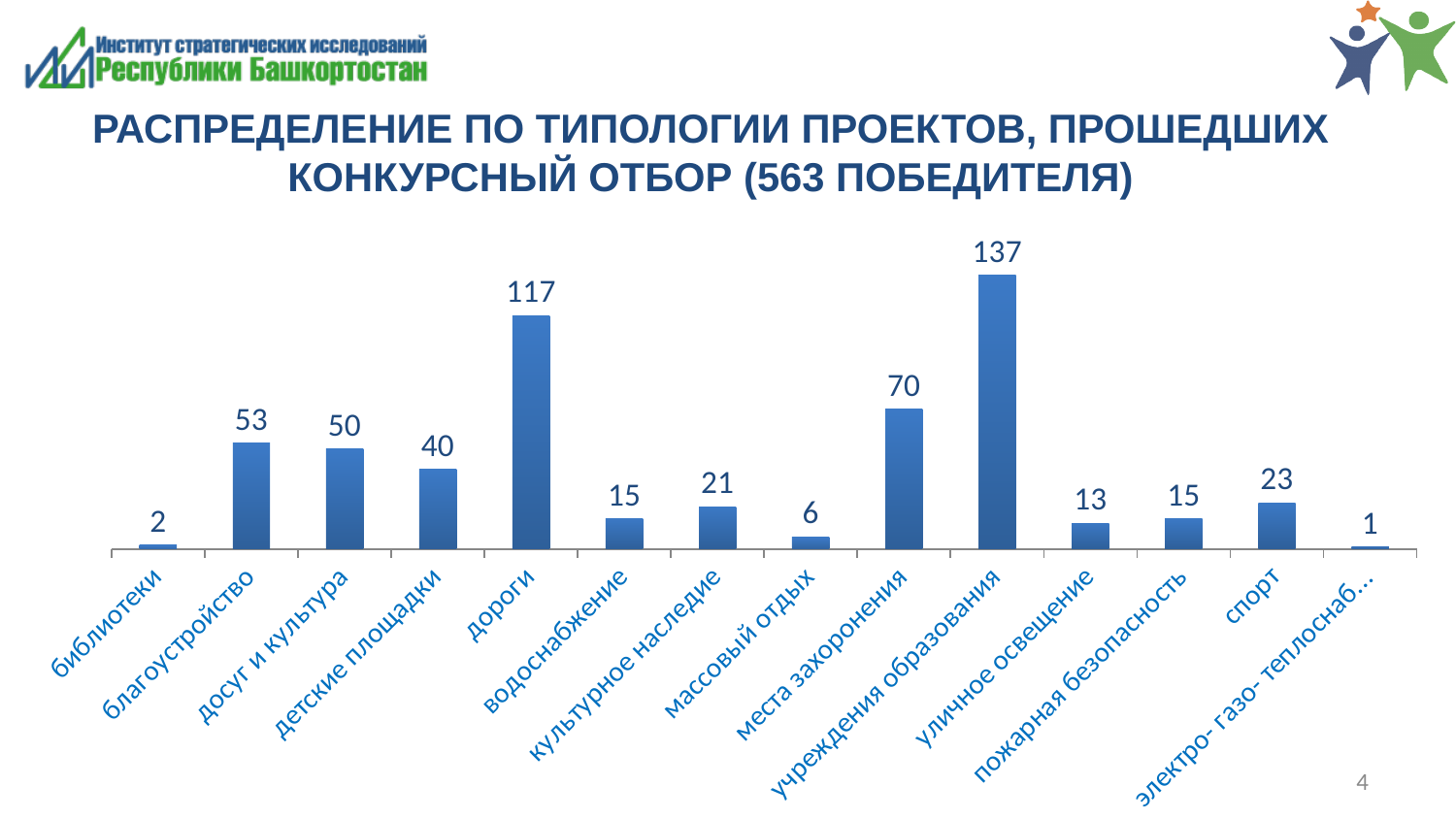
What is the difference between the values for учреждения образования and дороги? 20 What is the value for детские площадки? 40 What is the value for места захоронения? 70 What is the value for дороги? 117 What kind of chart is shown on the slide? bar chart What is the difference between the values for благоустройство and досуг и культура? 3 Which category has the highest value? учреждения образования Which is larger, the value for спорт or the value for культурное наследие? спорт Which category has the lowest value? электро- газо- теплоснаб… What is the total number of winners stated in the chart title? 563 How many categories are shown on the x axis? 14 Which is larger, the value for массовый отдых or the value for уличное освещение? уличное освещение